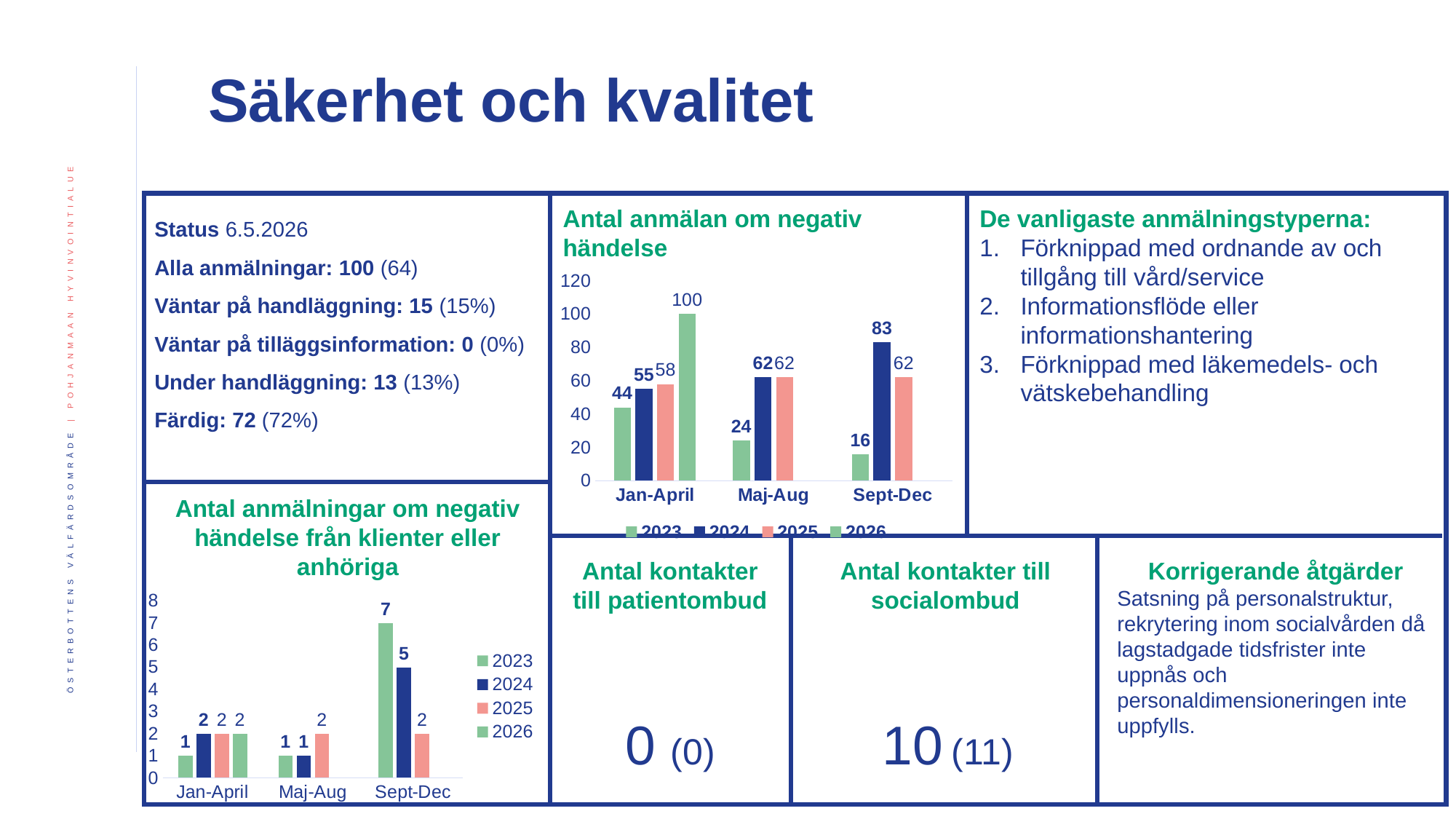
In the chart 'Antal anmälningar om negativ händelse från klienter eller anhöriga', what is the value for 2023 in Sept-Dec? 7 In the chart 'Antal anmälningar om negativ händelse från klienter eller anhöriga', what is the difference between the 2023 and 2024 values in Sept-Dec? 2 In the chart 'Antal anmälan om negativ händelse', which is larger in Jan-April: the 2025 value or the 2023 value? 2025 In the chart 'Antal anmälan om negativ händelse', how many series does the legend list? 4 In the chart 'Antal anmälan om negativ händelse', what is the value for 2023 in Maj-Aug? 24 In the chart 'Antal anmälan om negativ händelse', do the 2023 values rise or fall from Jan-April to Sept-Dec? fall What kind of chart is 'Antal anmälningar om negativ händelse från klienter eller anhöriga'? bar chart In the chart 'Antal anmälan om negativ händelse', which period has the lowest value for 2023? Sept-Dec In the chart 'Antal anmälan om negativ händelse', what is the value for 2024 in Sept-Dec? 83 In the chart 'Antal anmälningar om negativ händelse från klienter eller anhöriga', what is the value for 2025 in Maj-Aug? 2 In the chart 'Antal anmälan om negativ händelse', what is the value for 2026 in Jan-April? 100 In the chart 'Antal anmälan om negativ händelse', what is the difference between the 2024 and 2023 values in Sept-Dec? 67